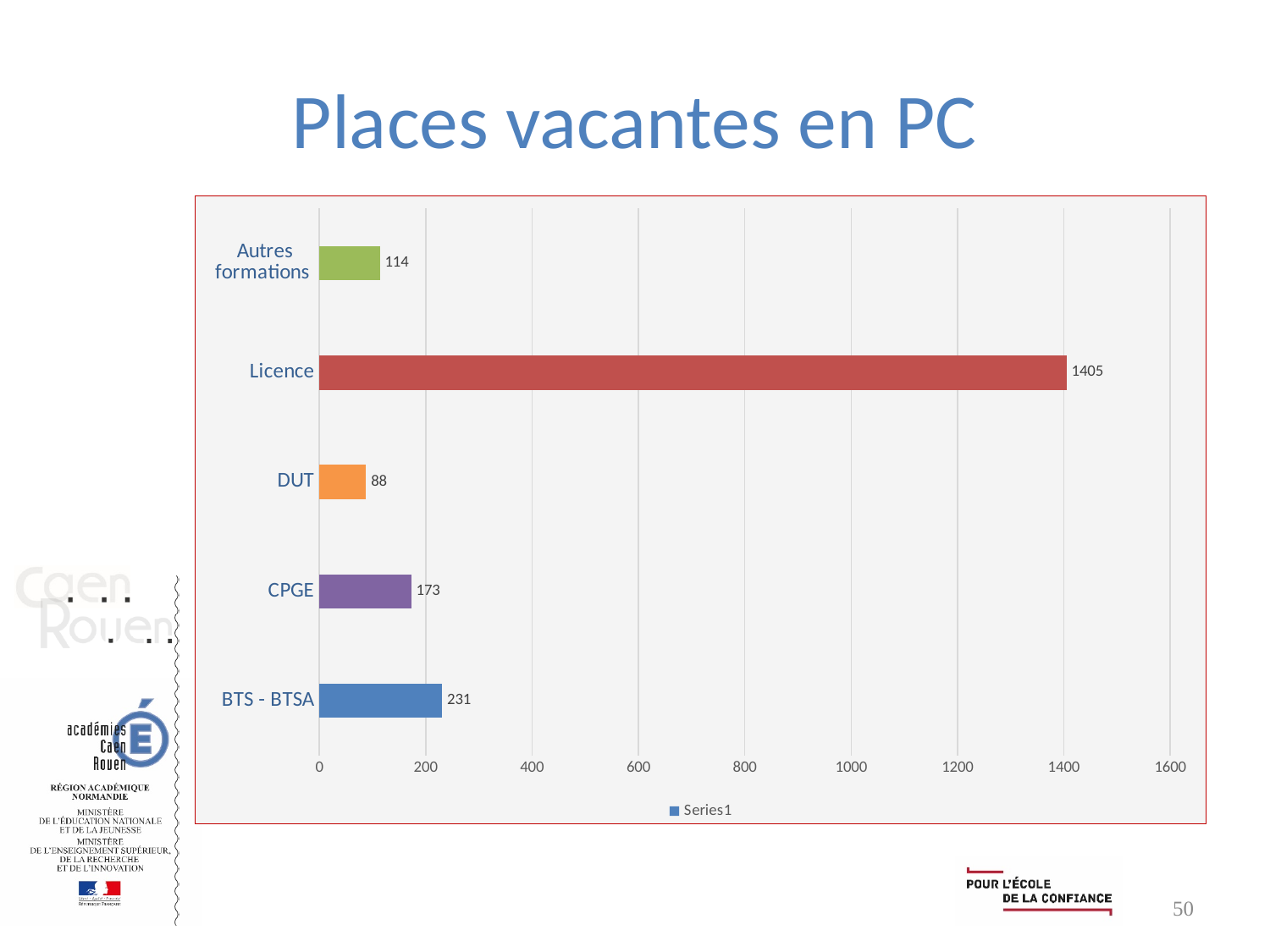
Which category has the lowest value? DUT What is the difference between the values for CPGE and Autres formations? 59 What is the title of the slide? Places vacantes en PC How many categories are shown in the chart? 5 Which is larger, the value for CPGE or the value for DUT? CPGE Which category has the highest value? Licence What is the value for Autres formations? 114 What is the difference between the values for Licence and BTS - BTSA? 1174 What is the value for BTS - BTSA? 231 What is the value for DUT? 88 What is the value for Licence? 1405 What kind of chart is shown on the slide? bar chart